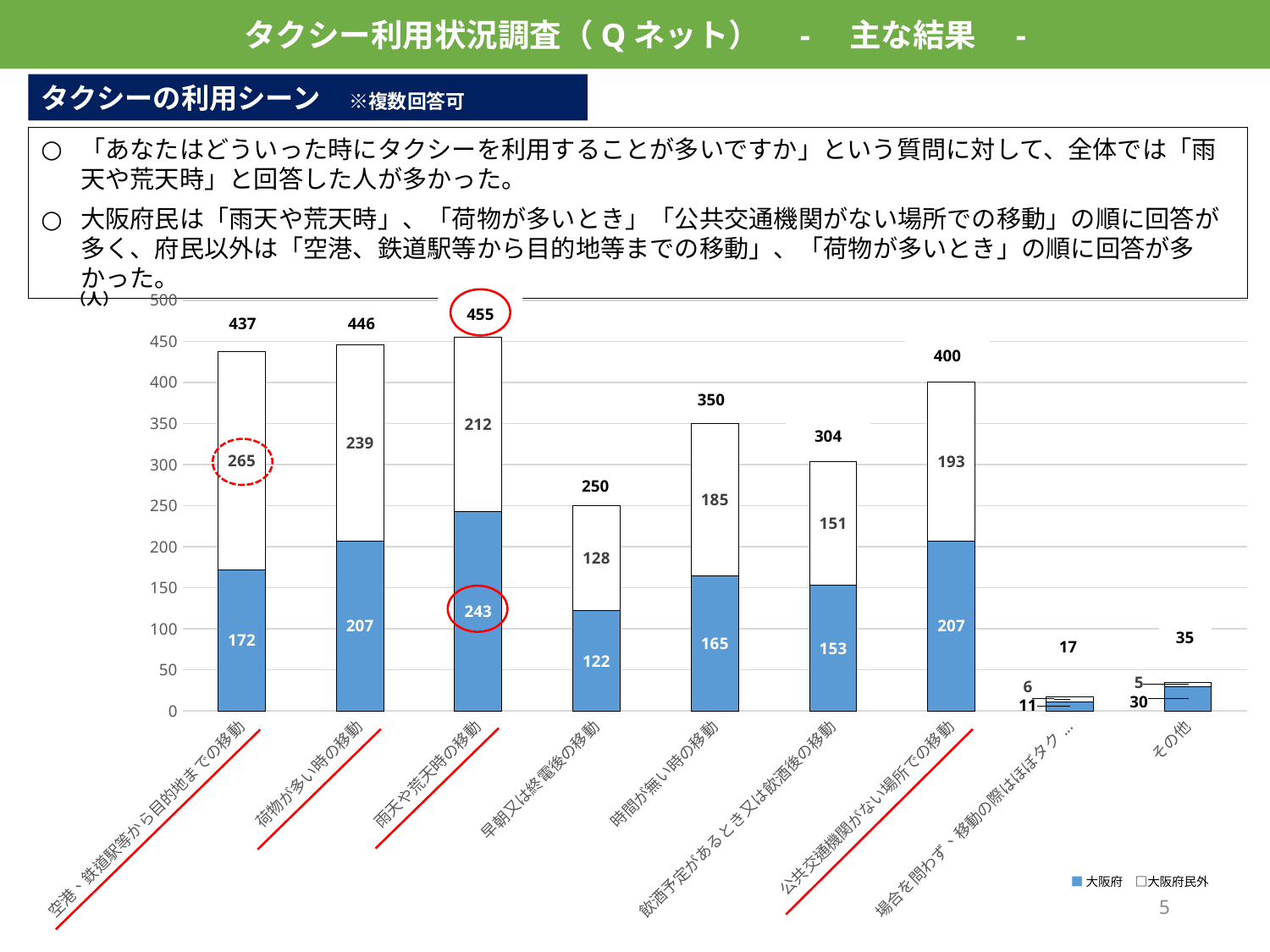
Is the total for 時間が無い時の移動 greater or less than 300? greater What is the 大阪府 value for 雨天や荒天時の移動? 243 What is the 大阪府民外 value for 空港、鉄道駅等から目的地までの移動? 265 Which series is shown in blue in the legend? 大阪府 What is the total of the stacked bar for 荷物が多い時の移動? 446 How many series does the legend list? 2 What kind of chart is shown on the slide? stacked bar chart Which category has the lowest total? 場合を問わず、移動の際はほぼタク… What is the difference between the 大阪府 value and the 大阪府民外 value for 公共交通機関がない場所での移動? 14 Which is larger for 早朝又は終電後の移動: the 大阪府 value or the 大阪府民外 value? 大阪府民外 Which category has the highest total? 雨天や荒天時の移動 How many categories are shown on the x axis? 9